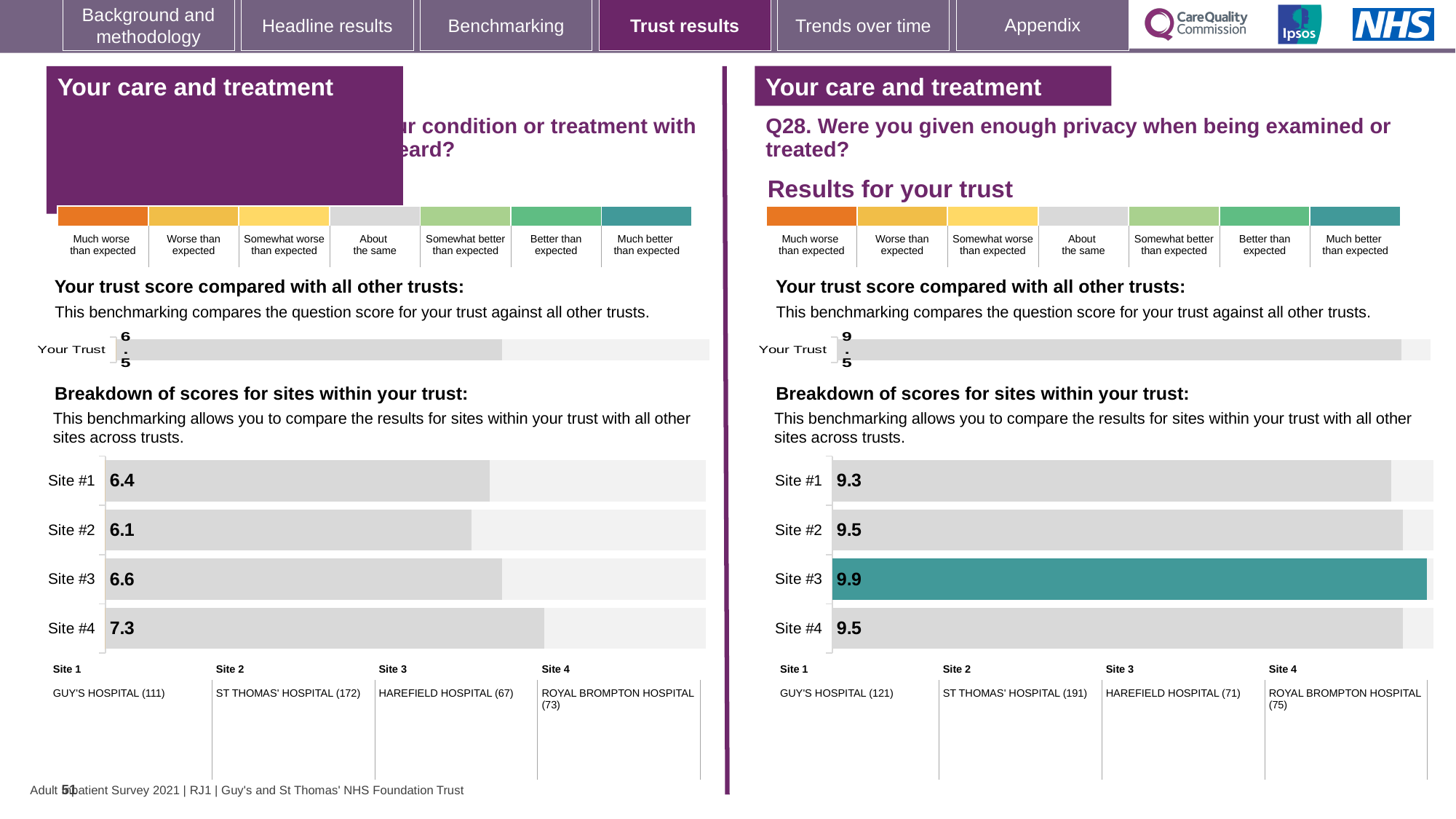
On the Q28 site breakdown chart, what is the score for Site #1? 9.3 On the left-hand site breakdown chart, what is the score for Site #4? 7.3 On the left-hand site breakdown chart, what is the difference between the scores for Site #4 and Site #1? 0.9 On the left-hand site breakdown chart, which site has the lowest score? Site #2 How many sites are shown on the Q28 site breakdown chart? 4 On the Q28 site breakdown chart, what is the difference between the scores for Site #3 and Site #1? 0.6 On the Q28 site breakdown chart, what is the score for Site #3? 9.9 On the Q28 'Your trust score compared with all other trusts' chart, what is the score for Your Trust? 9.5 On the left-hand 'Your trust score compared with all other trusts' chart, what is the score for Your Trust? 6.5 On the Q28 site breakdown chart, which site has the highest score? Site #3 On the left-hand site breakdown chart, what is the score for Site #2? 6.1 On the left-hand site breakdown chart, which site has the highest score? Site #4